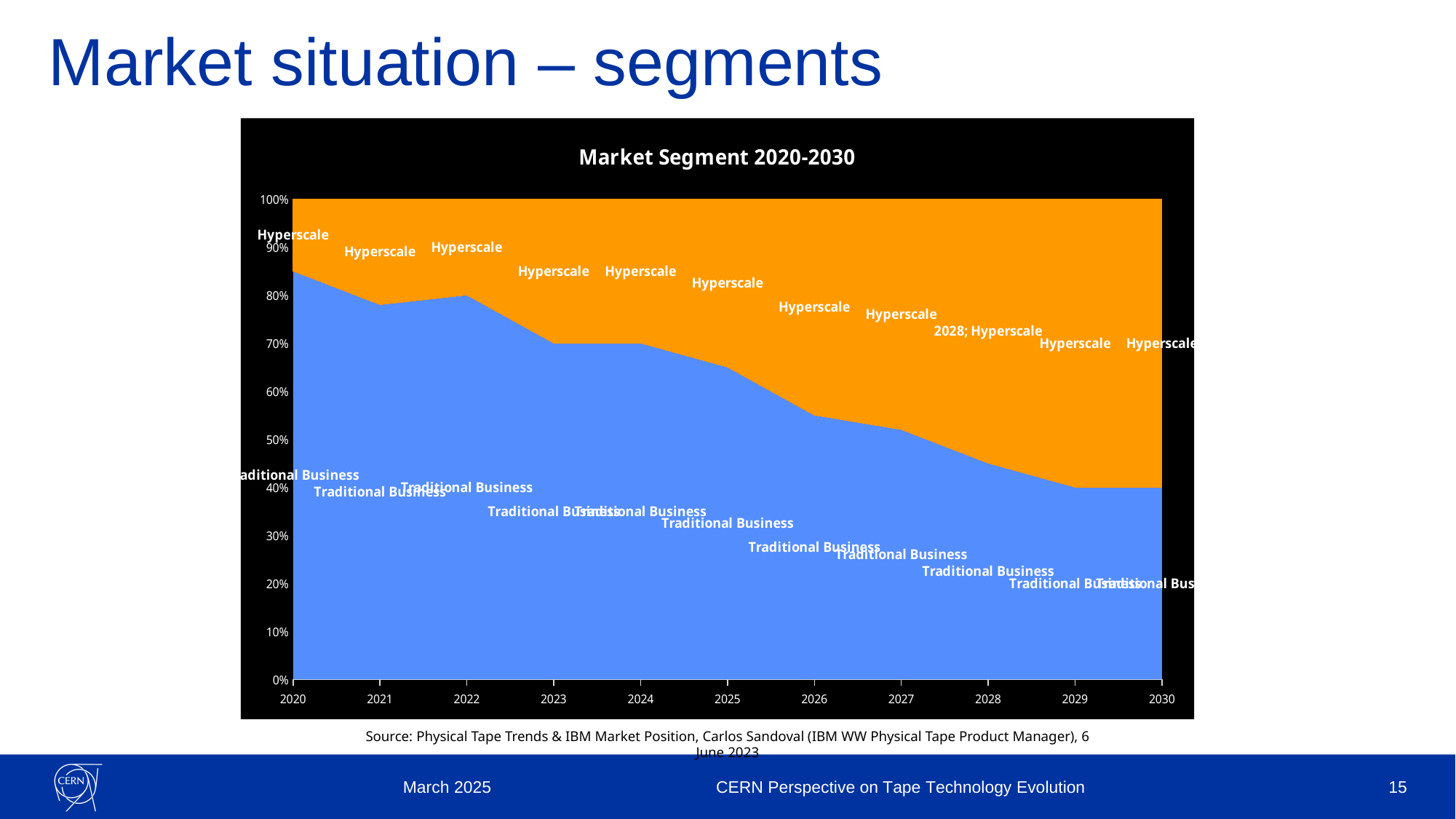
What is the title of the chart? Market Segment 2020-2030 What kind of chart is shown on the slide? area chart Which segment is shown in orange? Hyperscale Does the Traditional Business share rise or fall from 2020 to 2030? fall In 2030, which segment has the larger share, Hyperscale or Traditional Business? Hyperscale In which year is the Traditional Business share highest? 2020 Is the Traditional Business share in 2030 greater or less than 50%? less Is the Traditional Business share in 2023 greater or less than 80%? less How many years are plotted along the x axis? 11 Does the Hyperscale share rise or fall from 2020 to 2030? rise Is the Traditional Business share in 2020 greater or less than 80%? greater How many market segments (series) are shown in the chart? 2